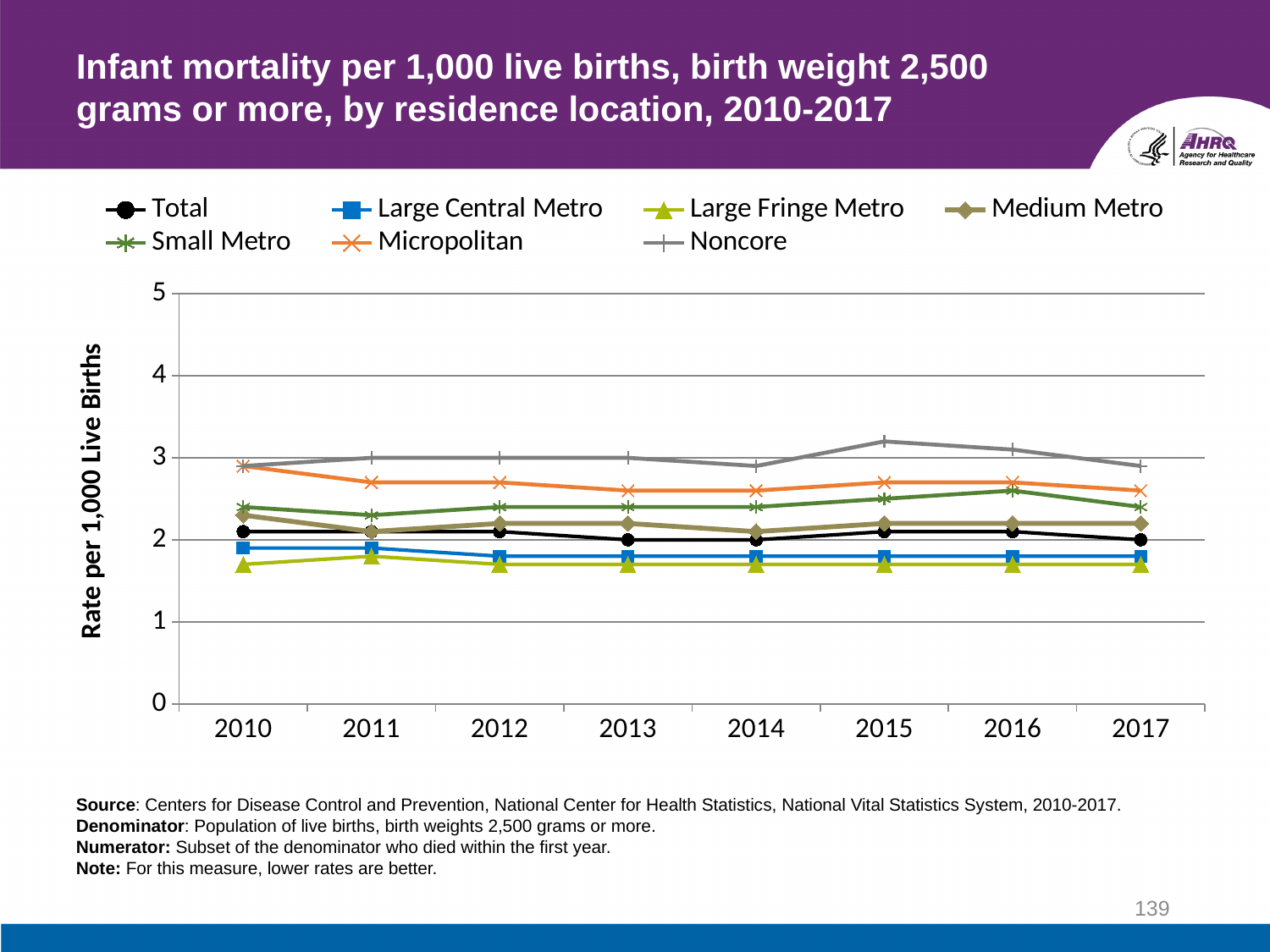
How many series does the legend list? 7 How many years are plotted along the x axis? 8 Is the value for Large Fringe Metro in 2017 greater or less than 2? less What kind of chart is shown on the slide? line chart Is the value for Micropolitan in 2013 greater or less than 3? less Which residence location has the lowest rate in 2015? Large Fringe Metro Is the value for Small Metro in 2016 greater or less than 2? greater Does the Micropolitan rate rise or fall from 2010 to 2013? fall What is the label on the y axis? Rate per 1,000 Live Births In 2012, which is larger: the rate for Micropolitan or the rate for Total? Micropolitan Which residence location has the highest rate in 2015? Noncore